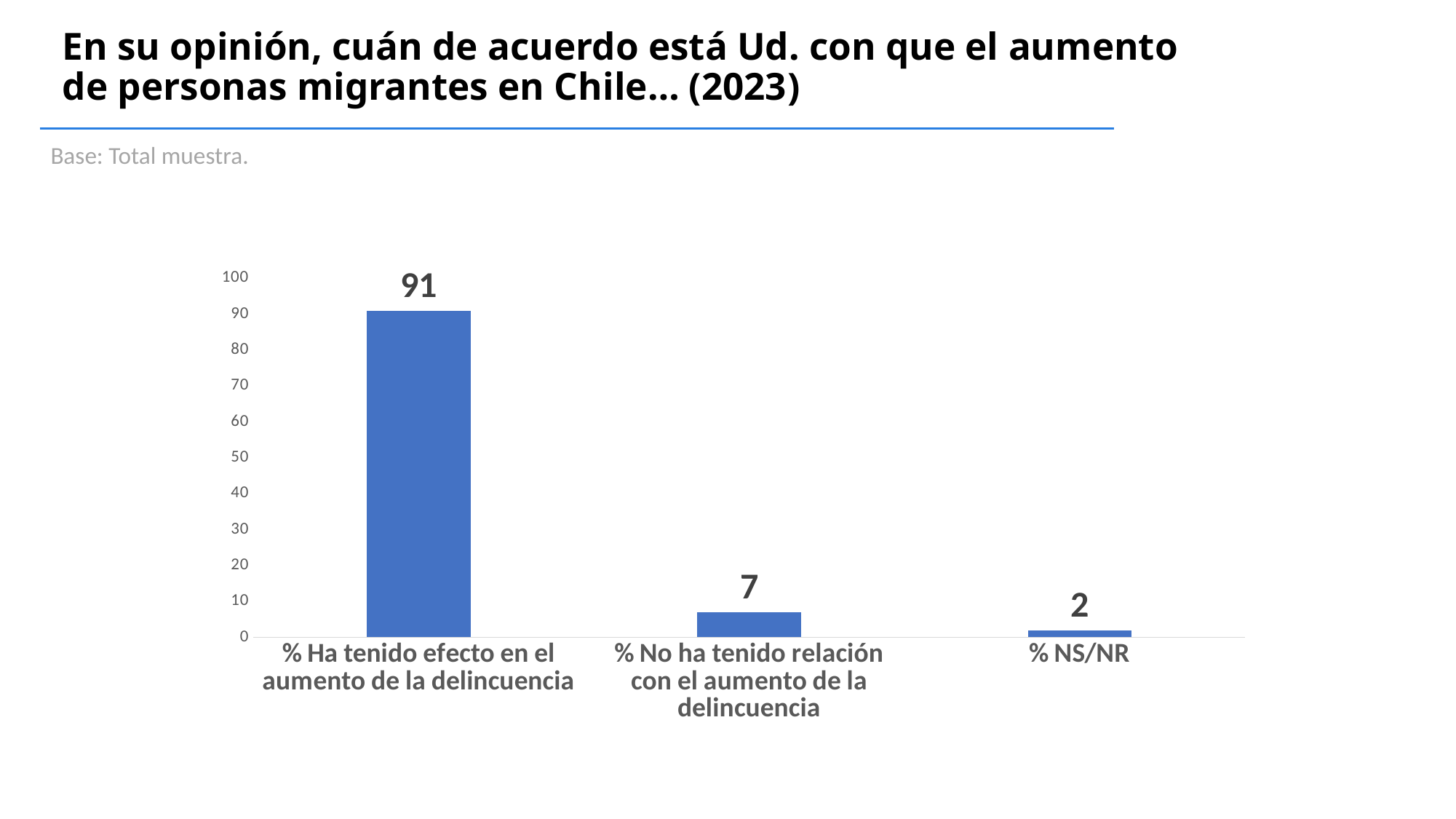
What kind of chart is shown on the slide? bar chart What is the difference between the values for "% No ha tenido relación con el aumento de la delincuencia" and "% NS/NR"? 5 Which is larger: the value for "% No ha tenido relación con el aumento de la delincuencia" or the value for "% NS/NR"? % No ha tenido relación con el aumento de la delincuencia What is the value for "% NS/NR"? 2 Is the value for "% Ha tenido efecto en el aumento de la delincuencia" greater or less than 50? greater What is the difference between the values for "% Ha tenido efecto en el aumento de la delincuencia" and "% No ha tenido relación con el aumento de la delincuencia"? 84 What is the base noted below the title of the slide? Total muestra Which category has the lowest value? % NS/NR What is the value for "% Ha tenido efecto en el aumento de la delincuencia"? 91 Which category has the highest value? % Ha tenido efecto en el aumento de la delincuencia What is the value for "% No ha tenido relación con el aumento de la delincuencia"? 7 How many categories are shown in the chart? 3